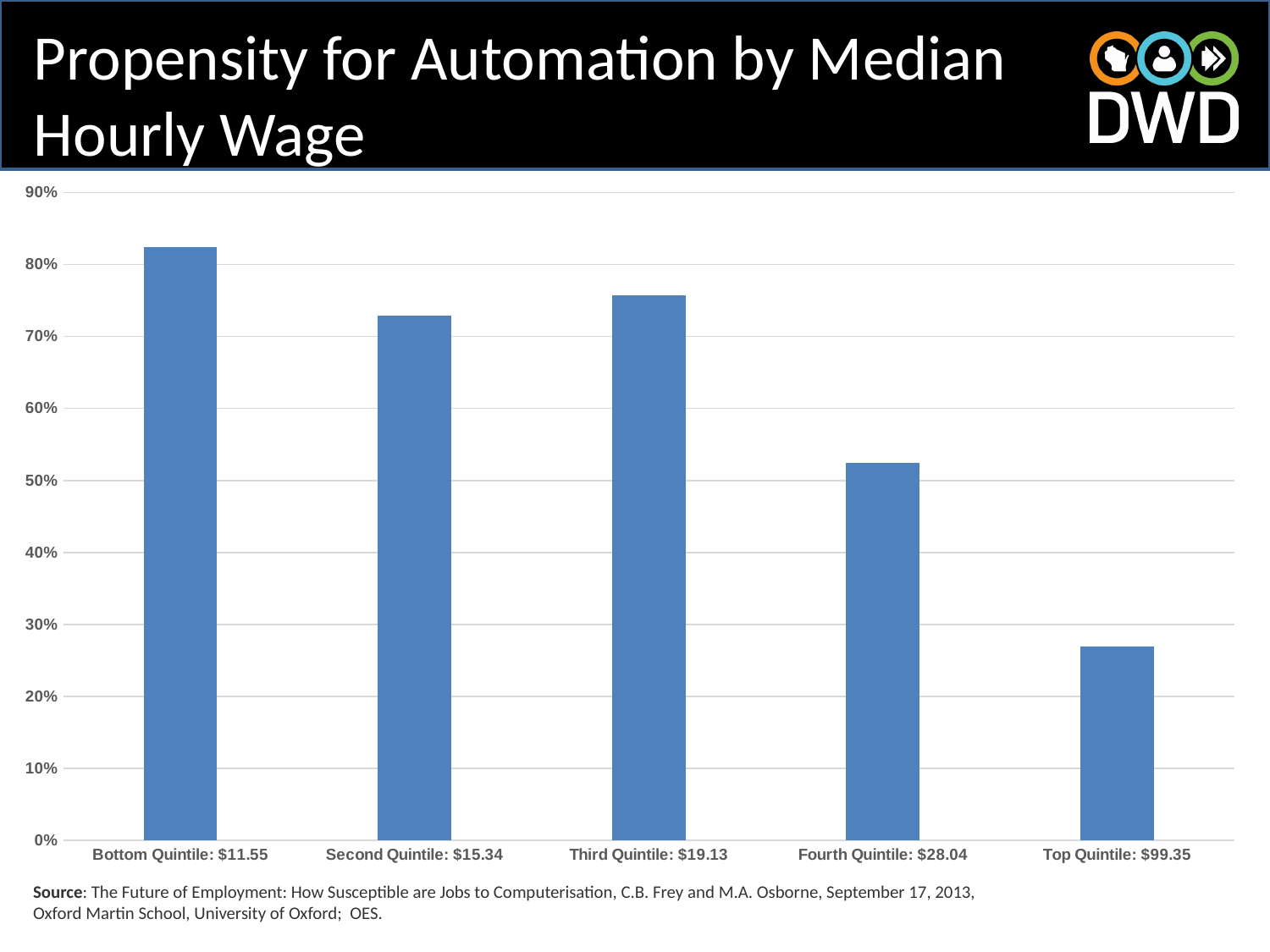
How many quintile categories are plotted on the chart? 5 Which has a higher propensity for automation, the Fourth Quintile: $28.04 or the Top Quintile: $99.35? Fourth Quintile: $28.04 Is the value for Top Quintile: $99.35 greater or less than 30%? less Which has a higher propensity for automation, the Second Quintile: $15.34 or the Third Quintile: $19.13? Third Quintile: $19.13 Which quintile has the lowest propensity for automation? Top Quintile: $99.35 Is the value for Third Quintile: $19.13 greater or less than 70%? greater Is the value for Fourth Quintile: $28.04 greater or less than 60%? less What kind of chart is shown on the slide? bar chart Which quintile has the highest propensity for automation? Bottom Quintile: $11.55 What is the title of the slide containing the chart? Propensity for Automation by Median Hourly Wage